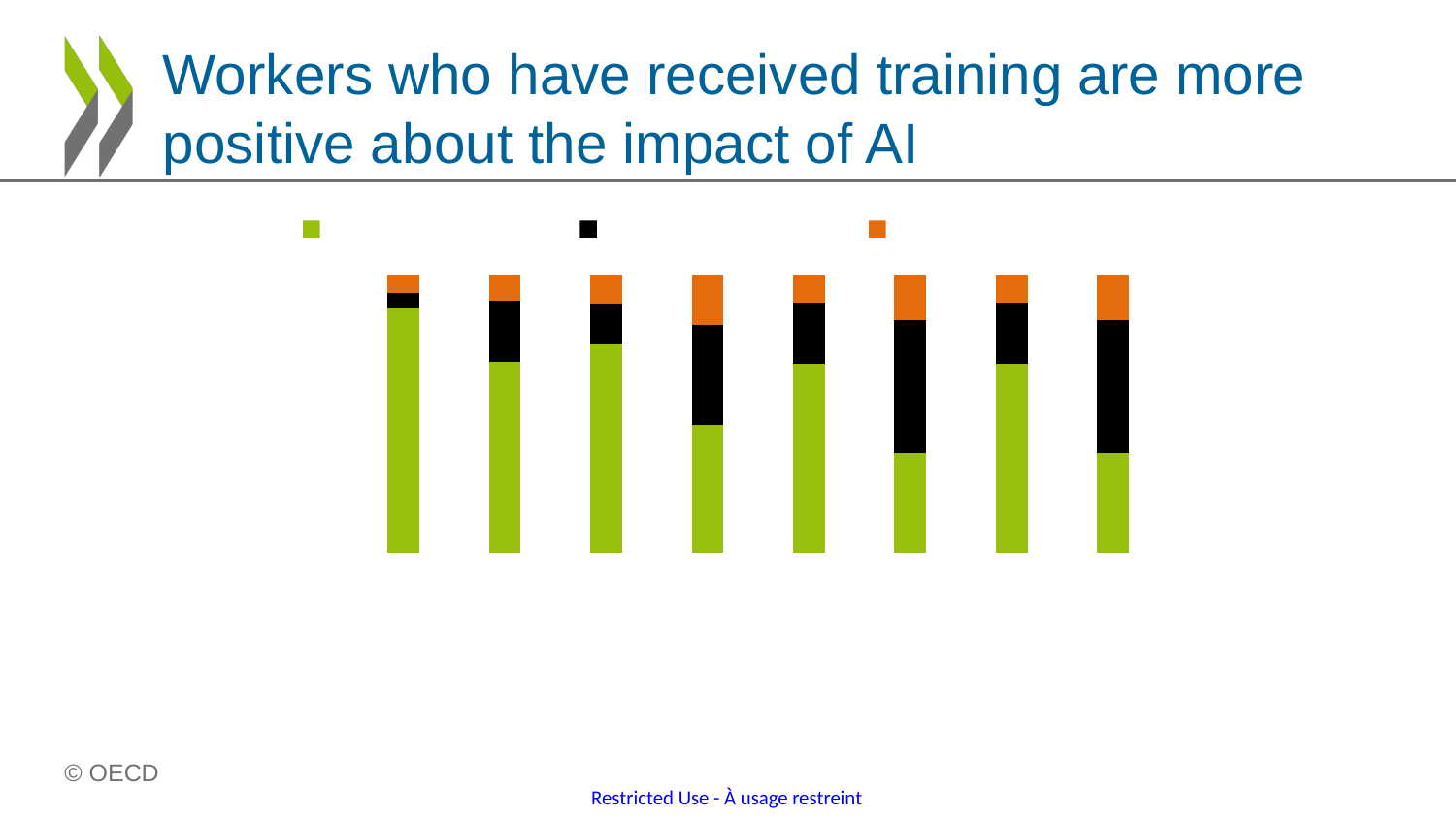
Which bar, counting from the left, has the largest orange segment? the fourth bar What colour is the bottom segment of each stacked bar? green What kind of chart is shown on the slide? bar chart Which bar, counting from the left, has the smallest black segment? the first bar Is the green segment larger in the first bar or in the fourth bar from the left? the first bar How many bars are plotted in the chart? 8 What colour is the top segment of each stacked bar? orange How many series does the legend list? 3 Which bar, counting from the left, has the tallest green segment? the first bar Is the black segment larger in the second bar or in the eighth bar from the left? the eighth bar